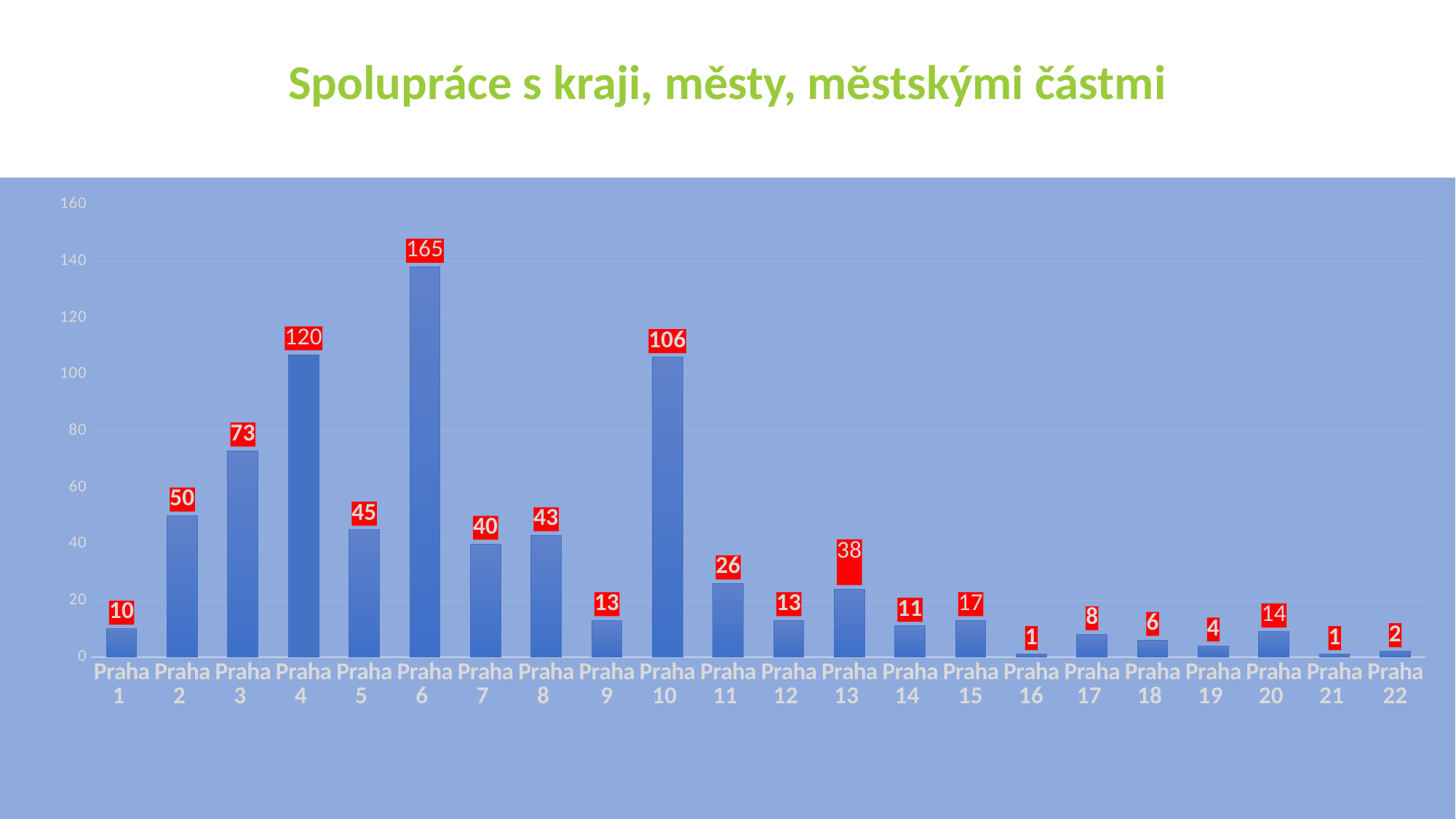
What is the value for Praha 10? 106 How many categories are shown on the x axis? 22 Which category has the highest value? Praha 6 What is the value for Praha 13? 38 What is the difference between the values for Praha 6 and Praha 10? 59 What is the difference between the values for Praha 4 and Praha 3? 47 Which has a larger value, Praha 2 or Praha 5? Praha 2 Which has a larger value, Praha 11 or Praha 15? Praha 11 What is the value for Praha 6? 165 What is the value for Praha 20? 14 What type of chart is shown on the slide? bar chart What is the title of the chart? Spolupráce s kraji, městy, městskými částmi